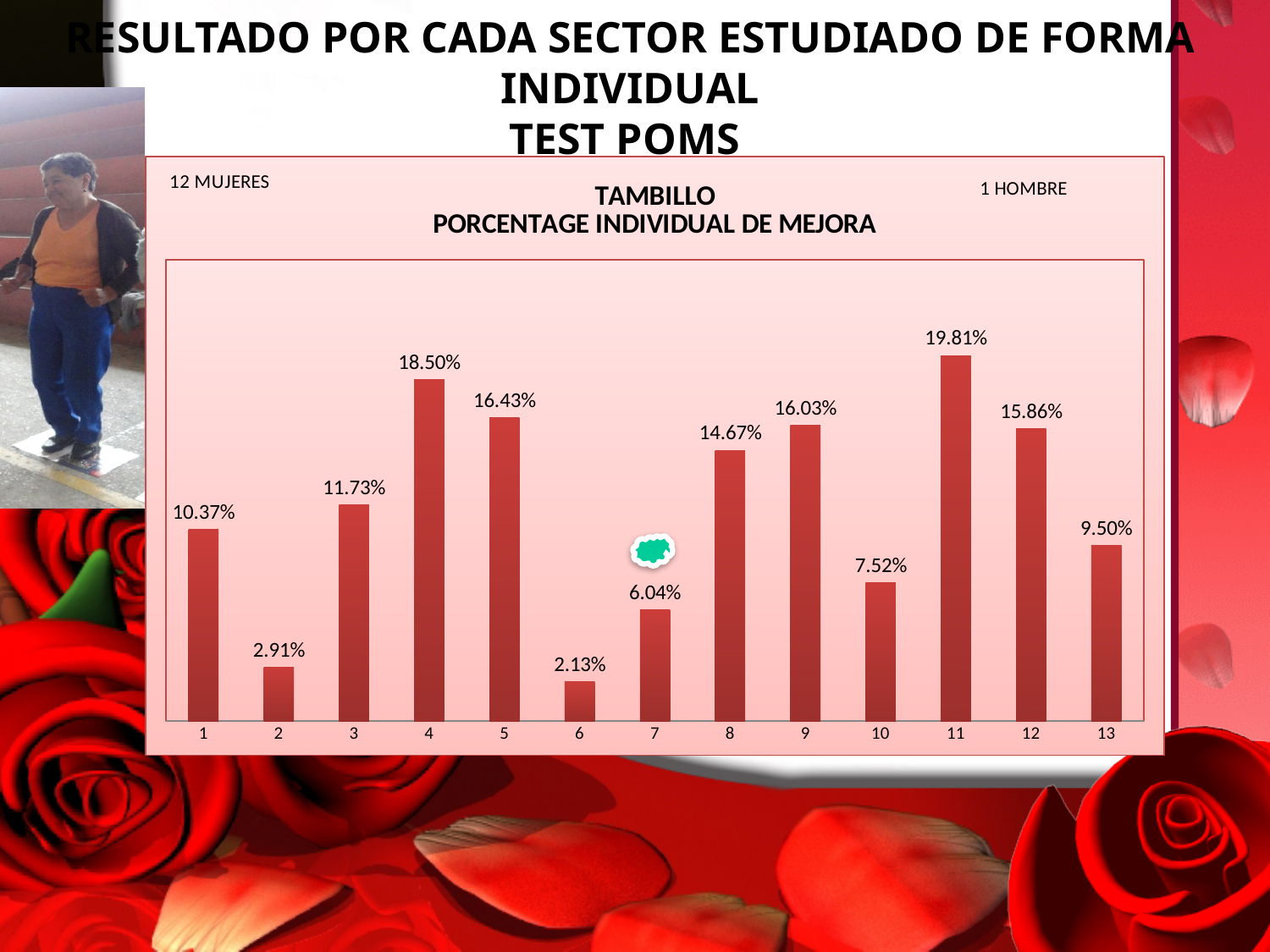
What is the value for category 11 in the TAMBILLO chart? 19.81% What is the difference between the values for category 4 and category 5? 2.07% What is the difference between the values for category 11 and category 6? 17.68% How many categories are shown on the x axis of the chart? 13 Which category has the lowest value in the TAMBILLO chart? 6 What is the value for category 6 in the TAMBILLO chart? 2.13% What is the title of the chart? TAMBILLO PORCENTAGE INDIVIDUAL DE MEJORA What kind of chart is shown on the slide? bar chart What is the value for category 13 in the TAMBILLO chart? 9.50% What is the value for category 4 in the TAMBILLO chart? 18.50% Which is larger, the value for category 8 or category 9? 9 Which category has the highest value in the TAMBILLO chart? 11